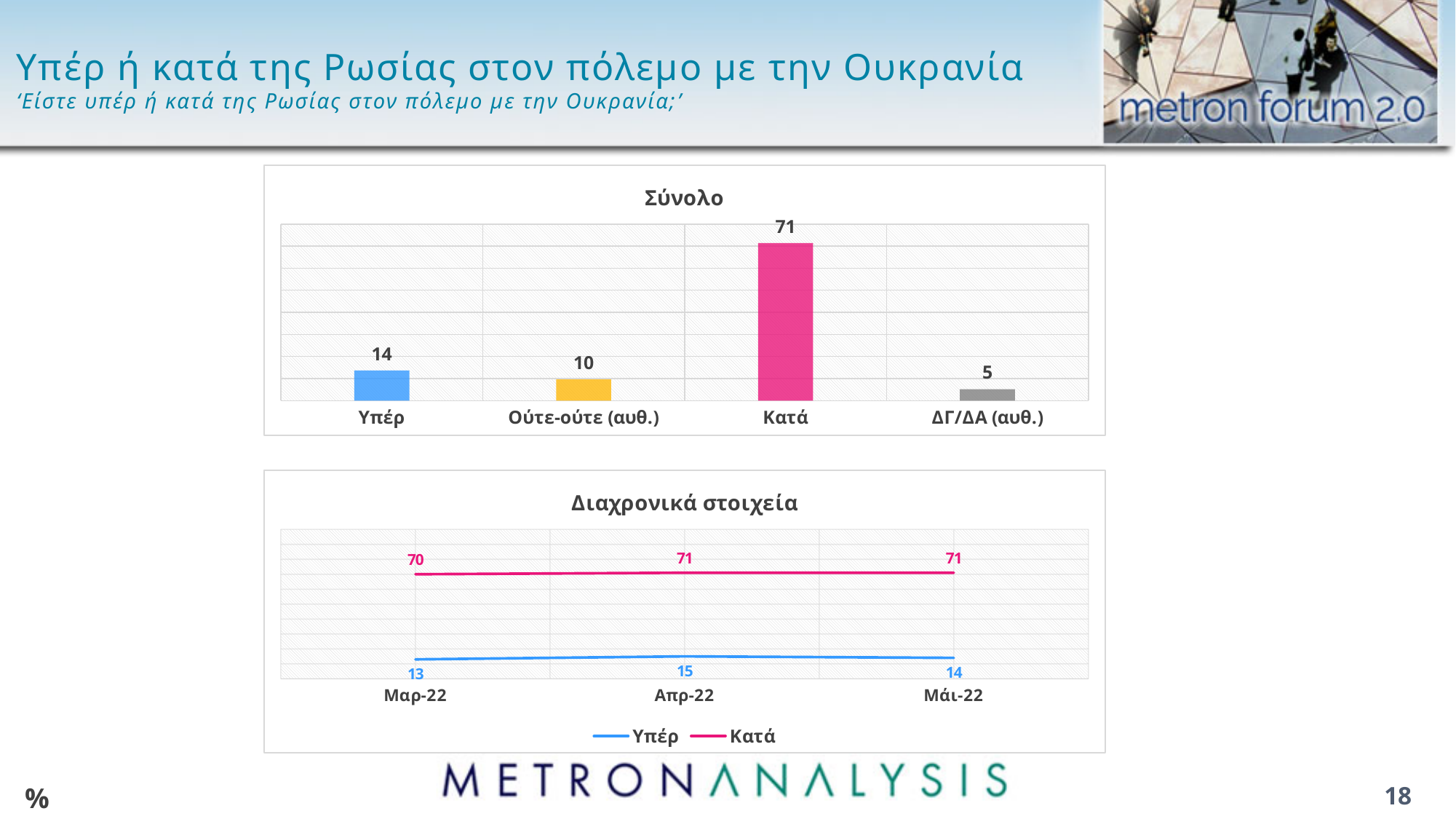
In the 'Σύνολο' chart, what is the value for Υπέρ? 14 In the 'Σύνολο' chart, which category has the lowest value? ΔΓ/ΔΑ (αυθ.) In the 'Σύνολο' chart, what is the difference between Κατά and Υπέρ? 57 In the 'Σύνολο' chart, which category has the highest value? Κατά In the 'Σύνολο' chart, what is the value for Κατά? 71 In the 'Σύνολο' chart, how many categories are shown? 4 What kind of chart is the 'Διαχρονικά στοιχεία' chart? Line chart In the 'Διαχρονικά στοιχεία' chart, which is larger in Μάι-22, Υπέρ or Κατά? Κατά In the 'Διαχρονικά στοιχεία' chart, what is the value for Υπέρ in Απρ-22? 15 What kind of chart is the 'Σύνολο' chart? Bar chart In the 'Διαχρονικά στοιχεία' chart, how many series does the legend list? 2 In the 'Διαχρονικά στοιχεία' chart, what is the value for Κατά in Μαρ-22? 70